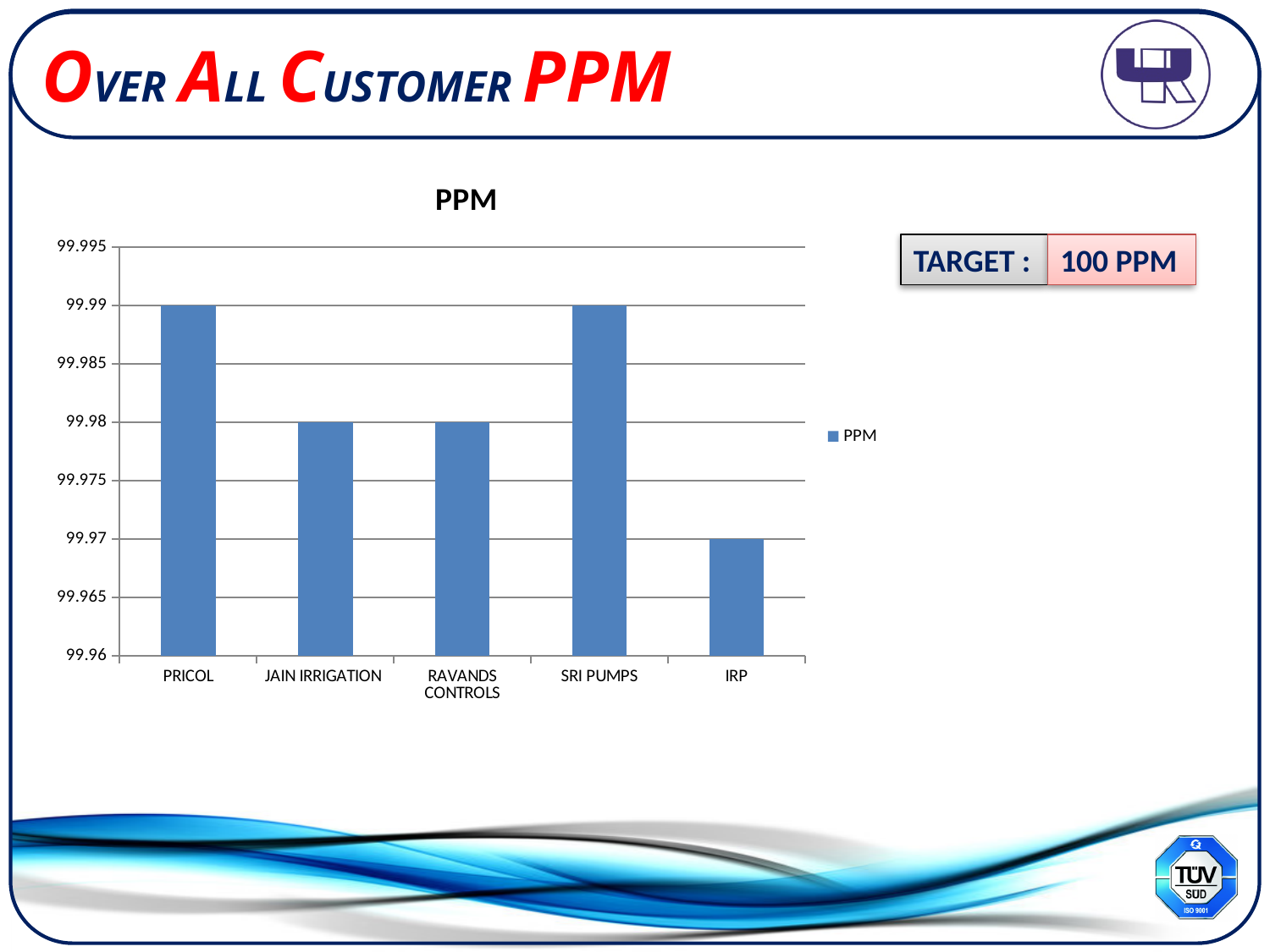
What kind of chart is shown? bar chart Which is larger, the value for SRI PUMPS or the value for RAVANDS CONTROLS? SRI PUMPS How many categories are shown on the x axis? 5 How many series does the legend list? 1 Which category has the lowest value? IRP What is the value for JAIN IRRIGATION? 99.98 What is the value for PRICOL? 99.99 What is the difference between the values for PRICOL and IRP? 0.02 What is the title of the chart? PPM What is the value for IRP? 99.97 Is the value for IRP greater or less than 99.975? less What is the value for SRI PUMPS? 99.99